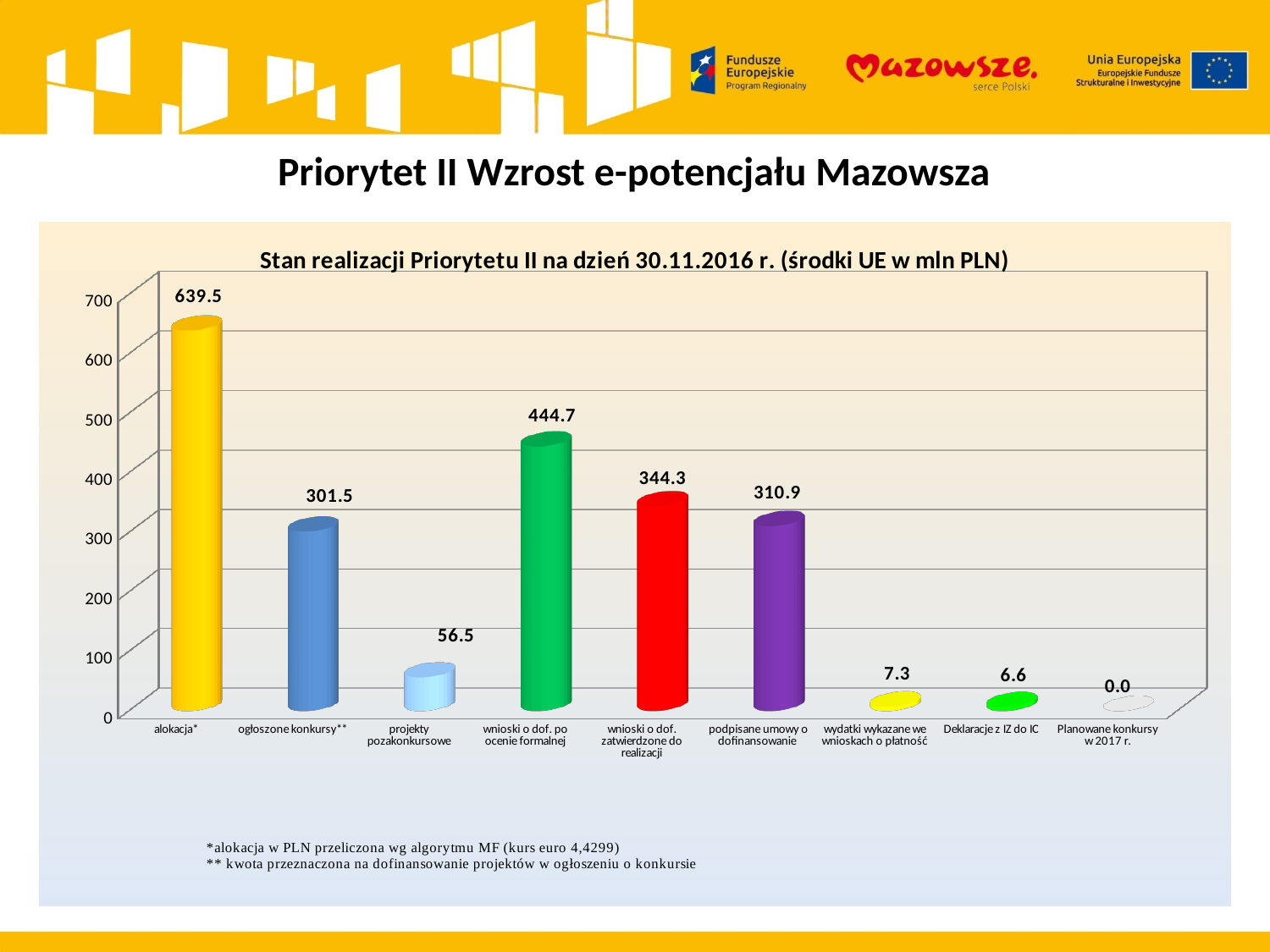
Which category has the lowest value? Planowane konkursy w 2017 r. Is the value for "projekty pozakonkursowe" greater or less than 100? less What is the title of the chart? Stan realizacji Priorytetu II na dzień 30.11.2016 r. (środki UE w mln PLN) What is the difference between "wnioski o dof. po ocenie formalnej" and "wnioski o dof. zatwierdzone do realizacji"? 100.4 What is the difference between "wydatki wykazane we wnioskach o płatność" and "Deklaracje z IZ do IC"? 0.7 Which is larger: "ogłoszone konkursy**" or "podpisane umowy o dofinansowanie"? podpisane umowy o dofinansowanie What is the value for "alokacja*"? 639.5 What is the value for "Deklaracje z IZ do IC"? 6.6 How many categories are shown on the x axis? 9 What kind of chart is shown on the slide? bar chart Which category has the highest value? alokacja* What is the value for "podpisane umowy o dofinansowanie"? 310.9